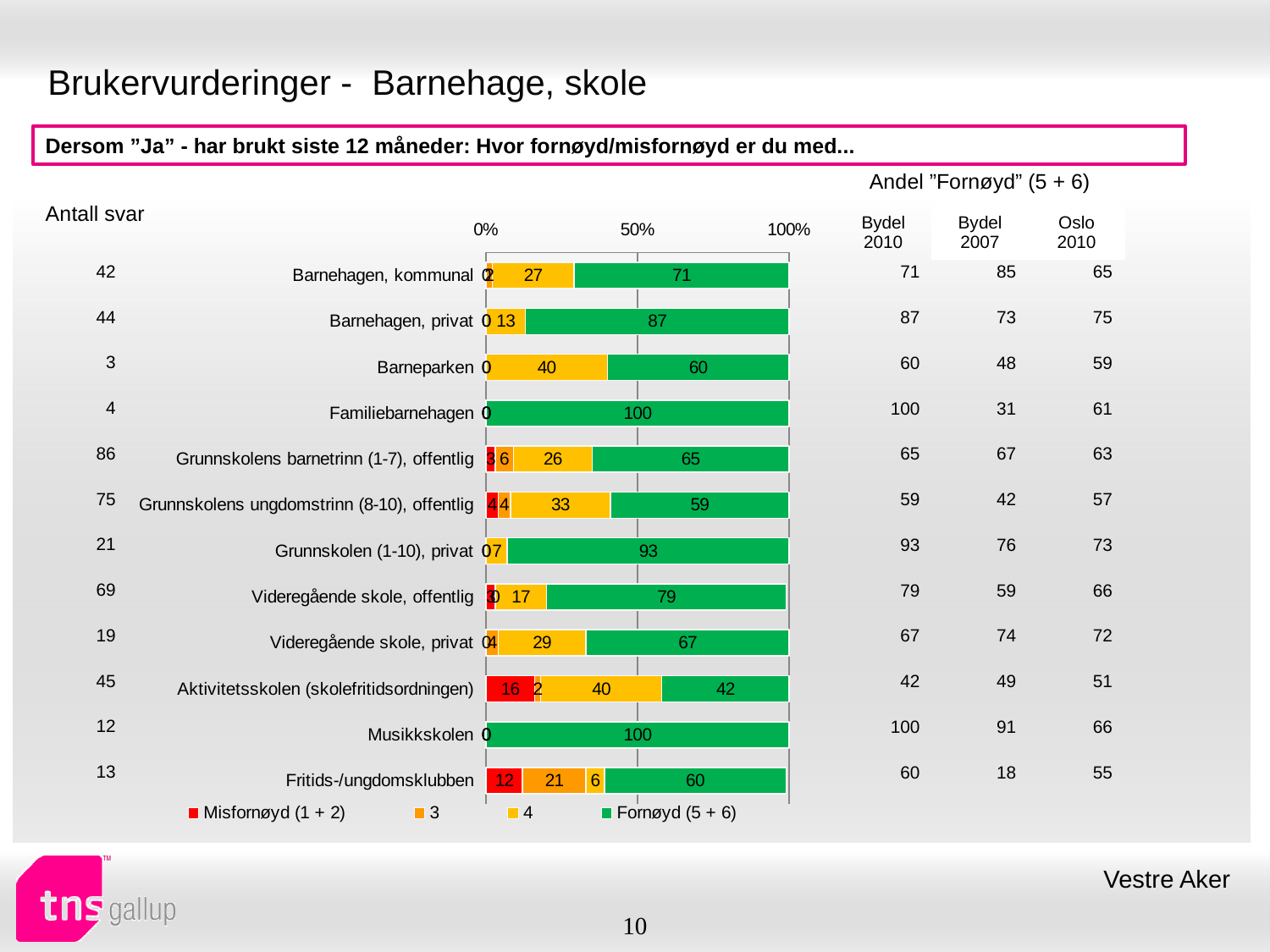
Which has a larger Fornøyd (5 + 6) value: Grunnskolen (1-10), privat or Videregående skole, offentlig? Grunnskolen (1-10), privat What is the last entry listed in the chart legend? Fornøyd (5 + 6) What kind of chart is shown on the slide? bar chart What is the value of series 4 for Grunnskolens ungdomstrinn (8-10), offentlig? 33 What is the value of series 3 for Fritids-/ungdomsklubben? 21 Which category has the highest Misfornøyd (1 + 2) value? Aktivitetsskolen (skolefritidsordningen) Which category has the lowest Fornøyd (5 + 6) value? Aktivitetsskolen (skolefritidsordningen) How many categories are plotted in the chart? 12 How many series does the chart legend list? 4 What is the Misfornøyd (1 + 2) value for Aktivitetsskolen (skolefritidsordningen)? 16 What is the Fornøyd (5 + 6) value for Barnehagen, privat? 87 What is the difference between the Fornøyd (5 + 6) values for Barnehagen, privat and Barnehagen, kommunal? 16